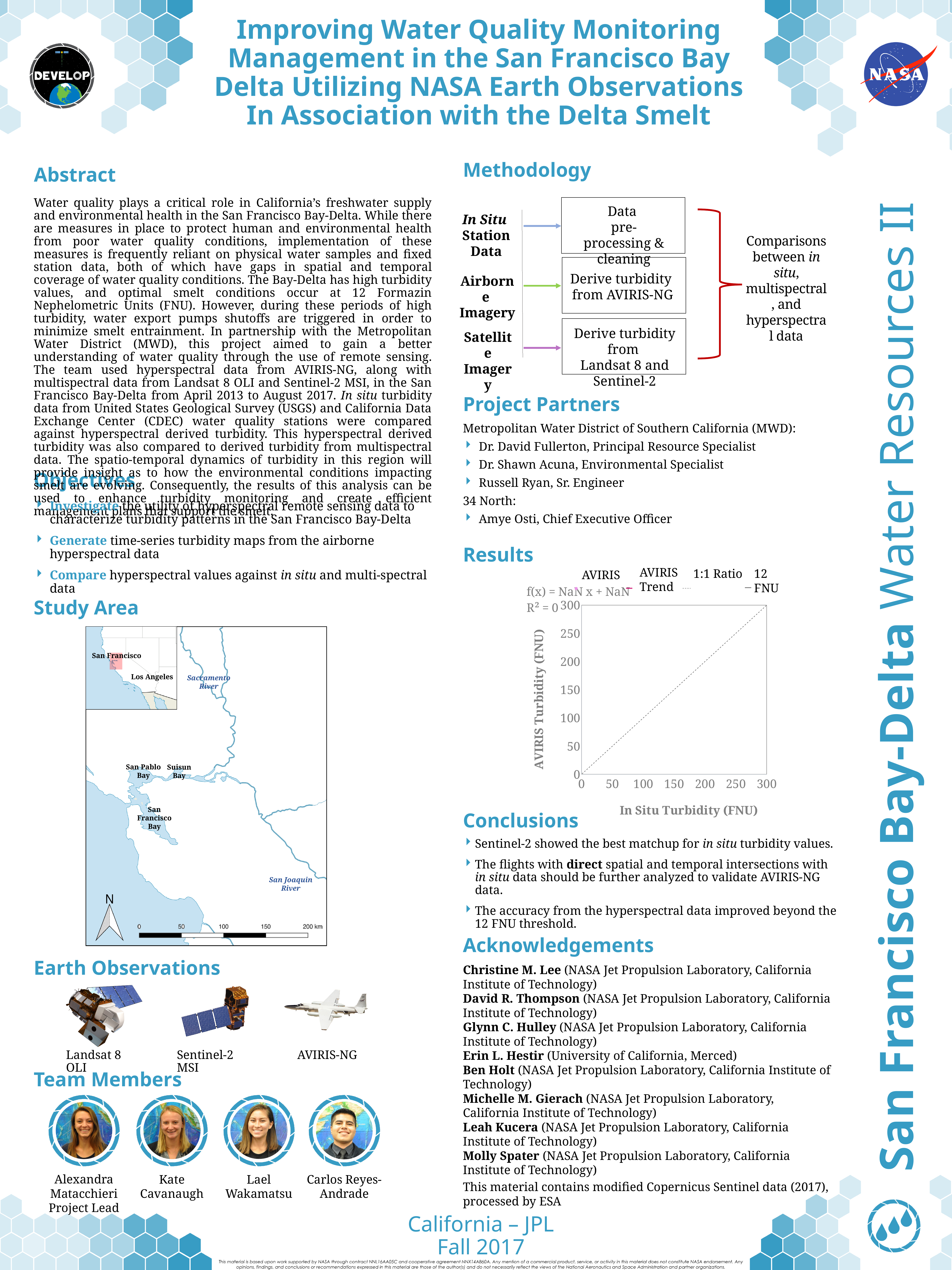
How many series does the legend of the Results chart list? 4 What kind of chart is shown in the Results section? scatter chart What is the label of the x axis on the Results chart? In Situ Turbidity (FNU) What is the label of the y axis on the Results chart? AVIRIS Turbidity (FNU) What R² value is printed on the Results chart? R² = 0